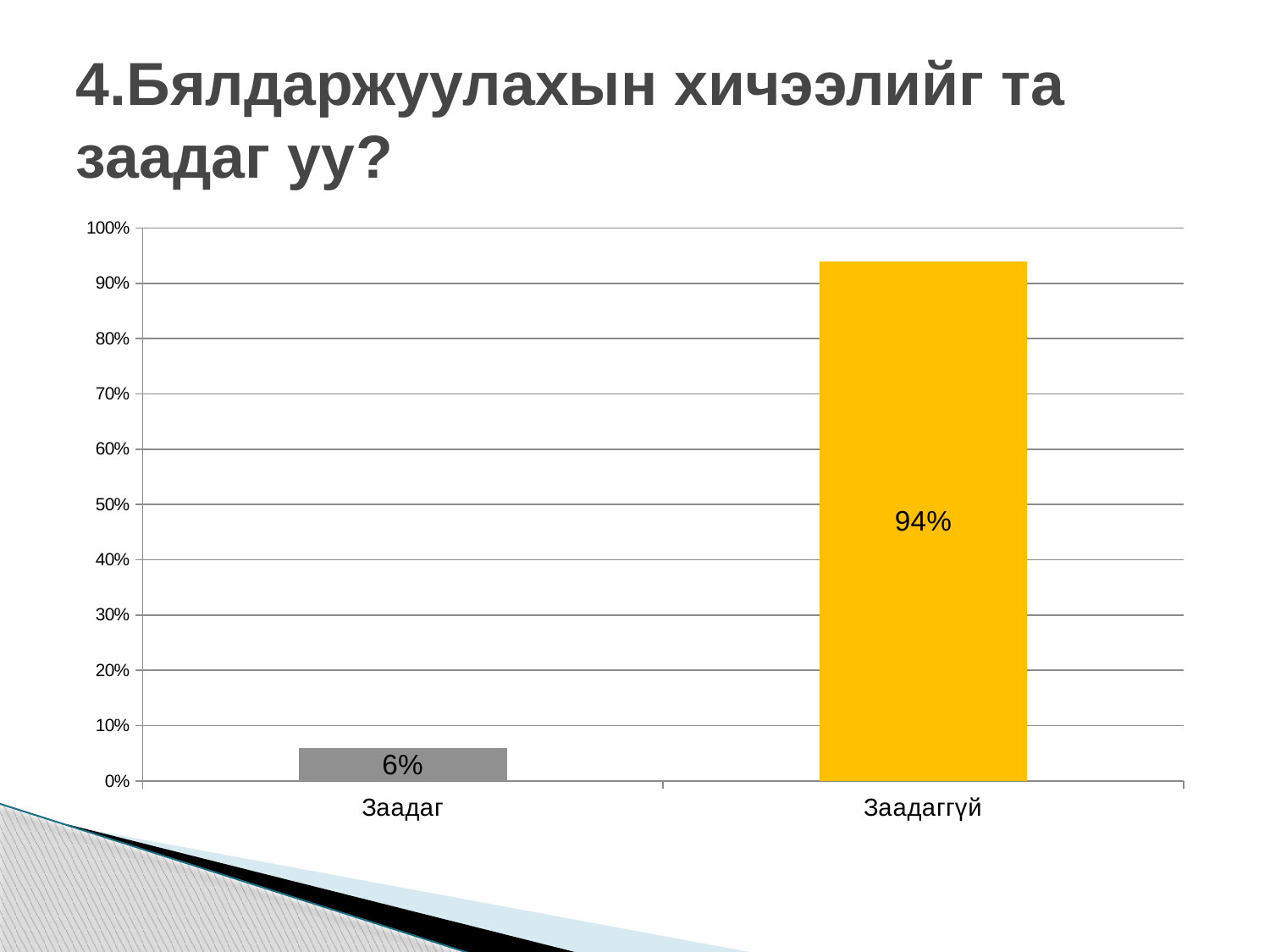
Is the value for Заадаг greater or less than 10%? less What is the value for Заадаг? 6% What is the value for Заадаггүй? 94% What is the title of the slide above the chart? 4.Бялдаржуулахын хичээлийг та заадаг уу? How many categories are shown on the x axis? 2 Which category has the lowest value? Заадаг Which category has the highest value? Заадаггүй Which is larger, the value for Заадаг or the value for Заадаггүй? Заадаггүй What is the difference between the values for Заадаггүй and Заадаг? 88% Is the value for Заадаггүй greater or less than 90%? greater What colour is the bar for Заадаггүй? yellow What kind of chart is shown on the slide? bar chart